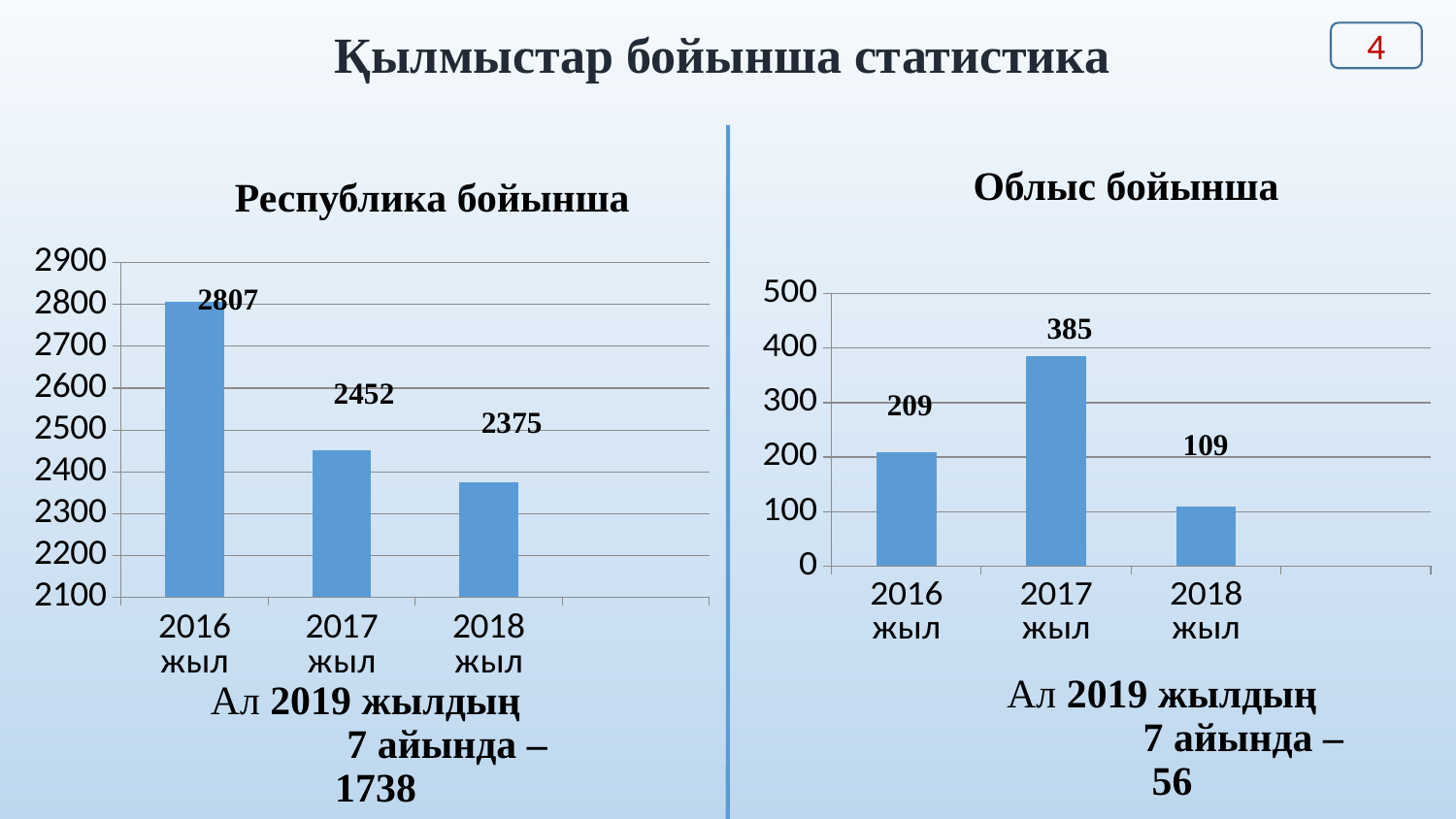
In the right chart (Облыс бойынша), what is the difference between the values for 2017 жыл and 2016 жыл? 176 In the left chart (Республика бойынша), what is the difference between the values for 2016 жыл and 2017 жыл? 355 In the right chart (Облыс бойынша), what is the value for 2018 жыл? 109 How many categories are shown in the left chart (Республика бойынша)? 3 In the right chart (Облыс бойынша), which is larger, the value for 2016 жыл or 2018 жыл? 2016 жыл In the left chart (Республика бойынша), do the values rise or fall from 2016 жыл to 2018 жыл? Fall In the left chart (Республика бойынша), which year has the highest value? 2016 жыл In the right chart (Облыс бойынша), which year has the lowest value? 2018 жыл In the right chart (Облыс бойынша), what is the value for 2017 жыл? 385 What kind of chart is the right chart (Облыс бойынша)? Bar chart In the left chart (Республика бойынша), what is the value for 2018 жыл? 2375 In the left chart (Республика бойынша), what is the value for 2016 жыл? 2807